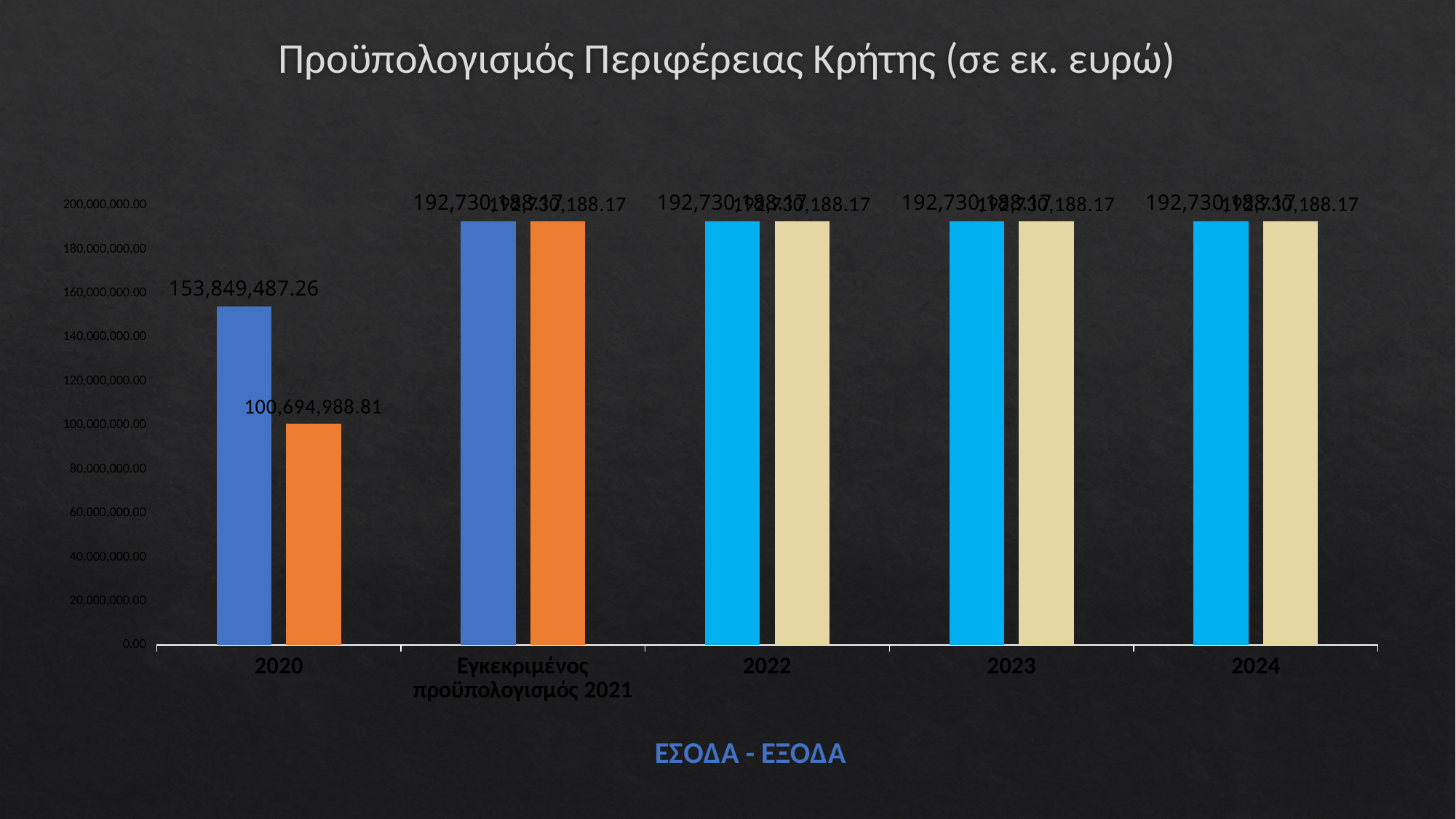
What text appears below the chart's x axis? ΕΣΟΔΑ - ΕΞΟΔΑ Does the first bar rise or fall from 2020 to Εγκεκριμένος προϋπολογισμός 2021? rises For 2020, which bar is larger, the first (blue) or the second (orange)? the first (blue), 153,849,487.26 What is the title of the chart? ΕΣΟΔΑ - ΕΞΟΔΑ What kind of chart is shown on the slide? bar chart Are the bars for 2022 greater or less than 180,000,000.00? greater What is the value of the second (orange) bar for 2020? 100,694,988.81 What is the difference between the two bars for 2020? 53,154,498.45 Which bar has the lowest value in the chart? the second (orange) bar for 2020, 100,694,988.81 How many categories are shown along the x axis? 5 Is the value of the second (orange) bar for 2020 greater or less than 120,000,000.00? less What is the value of the first (blue) bar for 2020? 153,849,487.26